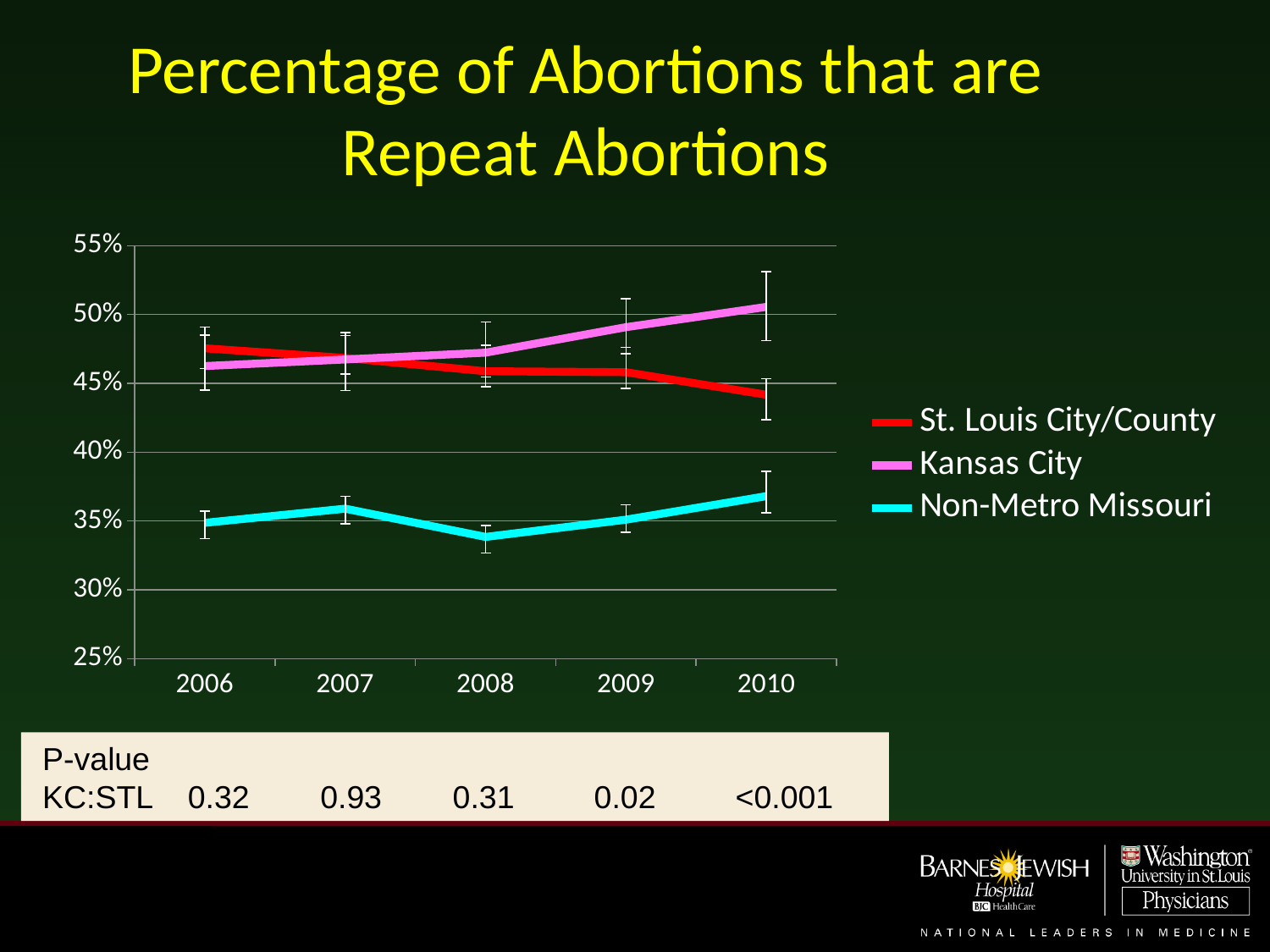
What kind of chart is shown on the slide? line chart What is the title of the chart? Percentage of Abortions that are Repeat Abortions How many years are plotted along the x axis? 5 In 2009, which is larger: the value for Kansas City or the value for St. Louis City/County? Kansas City Is the value for Non-Metro Missouri in 2008 greater or less than 35%? less How many series does the legend list? 3 Does the Kansas City line rise or fall from 2006 to 2010? rise Which series has the lowest value in 2008? Non-Metro Missouri Which series has the highest value in 2010? Kansas City Is the value for Non-Metro Missouri in 2010 greater or less than 35%? greater Is the value for St. Louis City/County in 2010 greater or less than 45%? less Does the St. Louis City/County line rise or fall from 2006 to 2010? fall